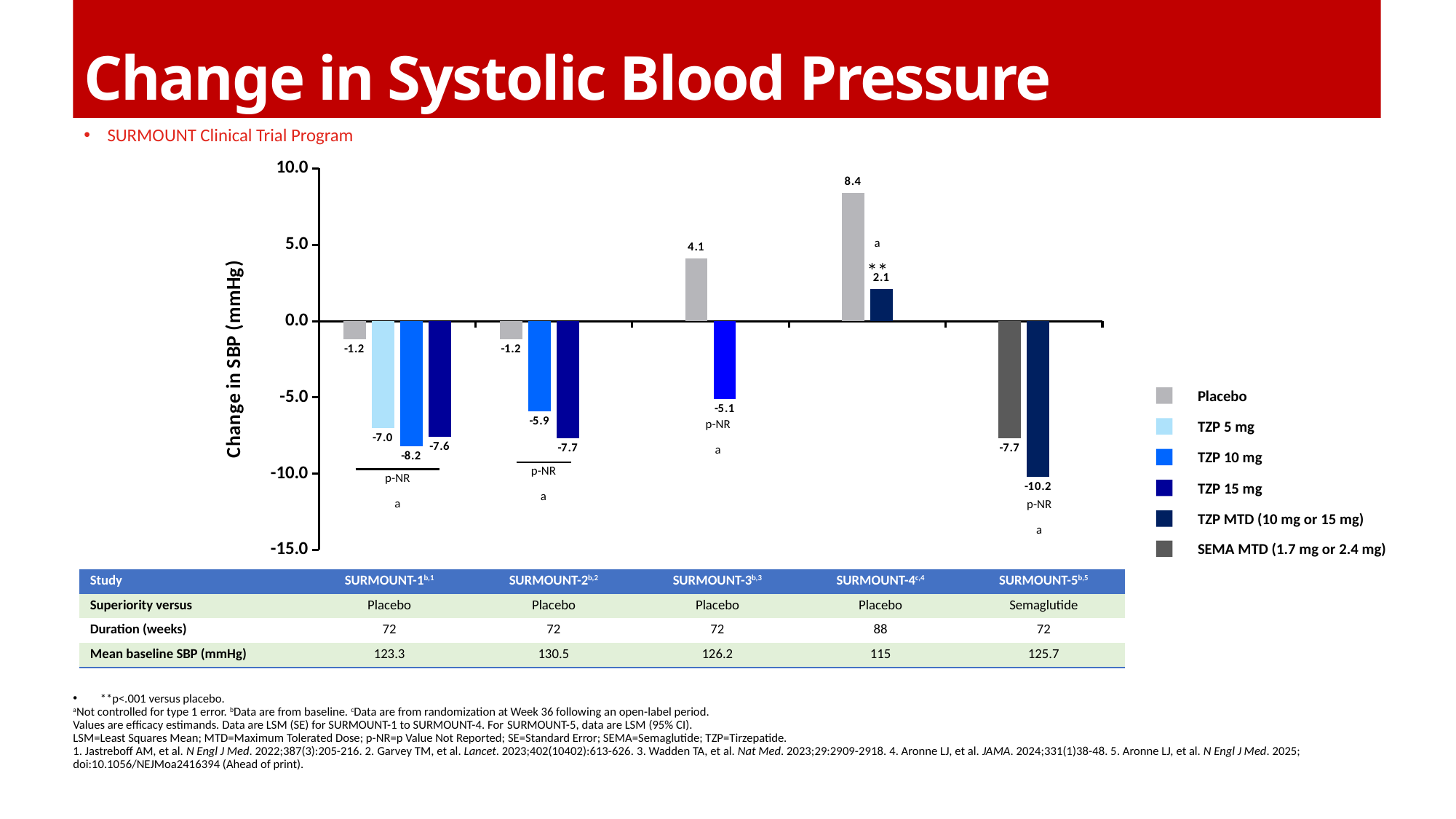
Which bar shows the largest reduction (lowest value) in SBP across the whole chart? TZP MTD in SURMOUNT-5 (-10.2) What is the change in SBP for SEMA MTD in SURMOUNT-5? -7.7 Which bar shows the highest value in the chart? Placebo in SURMOUNT-4 (8.4) What is the change in SBP for the placebo group in SURMOUNT-4? 8.4 What is the change in SBP for TZP 15 mg in SURMOUNT-2? -7.7 What is the change in SBP for TZP 10 mg in SURMOUNT-1? -8.2 What is the change in SBP for TZP MTD in SURMOUNT-5? -10.2 In SURMOUNT-1, which has a larger reduction in SBP: TZP 5 mg or TZP 15 mg? TZP 15 mg How many series does the legend list? 6 What is the difference between the TZP 10 mg and placebo changes in SBP in SURMOUNT-2? 4.7 What is the change in SBP for the placebo group in SURMOUNT-1? -1.2 What kind of chart is shown on the slide? Bar chart